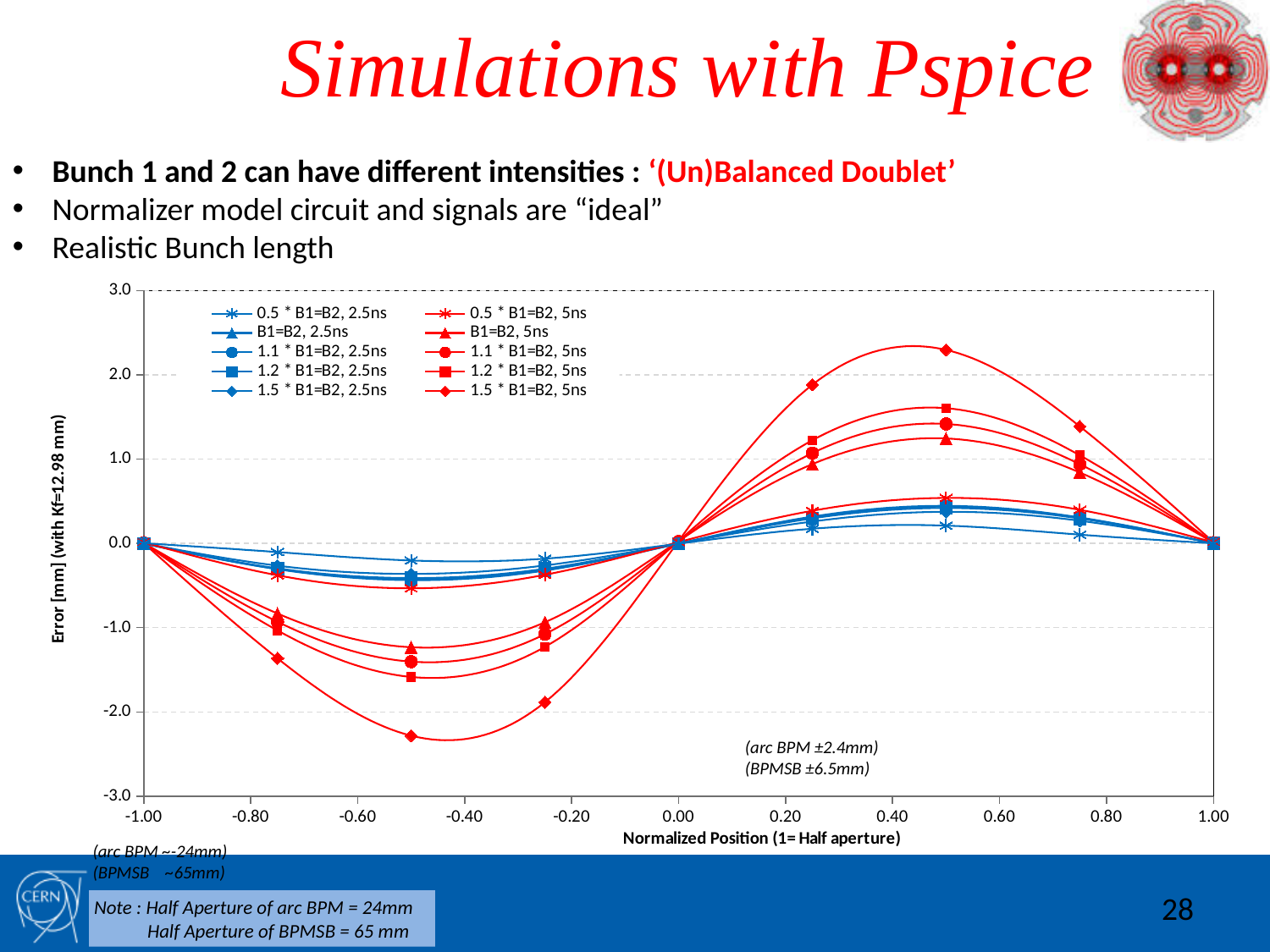
What is the title of the y axis of the chart? Error [mm] (with Kf=12.98 mm) How many series does the chart legend list? 10 Is the value for the 1.5 * B1=B2, 5ns series at normalized position 0.50 greater or less than 2.0? greater Which series reaches the highest error value on the chart? 1.5 * B1=B2, 5ns Is the value for the B1=B2, 2.5ns series at normalized position 0.50 greater or less than 1.0? less Is the value for the 1.5 * B1=B2, 5ns series at normalized position -0.50 greater or less than -2.0? less Which series reaches the lowest (most negative) error value on the chart? 1.5 * B1=B2, 5ns What kind of chart is shown on the slide? line chart What is the title of the x axis of the chart? Normalized Position (1= Half aperture) At normalized position 0.50, which series has the larger value: 1.5 * B1=B2, 5ns or 1.5 * B1=B2, 2.5ns? 1.5 * B1=B2, 5ns